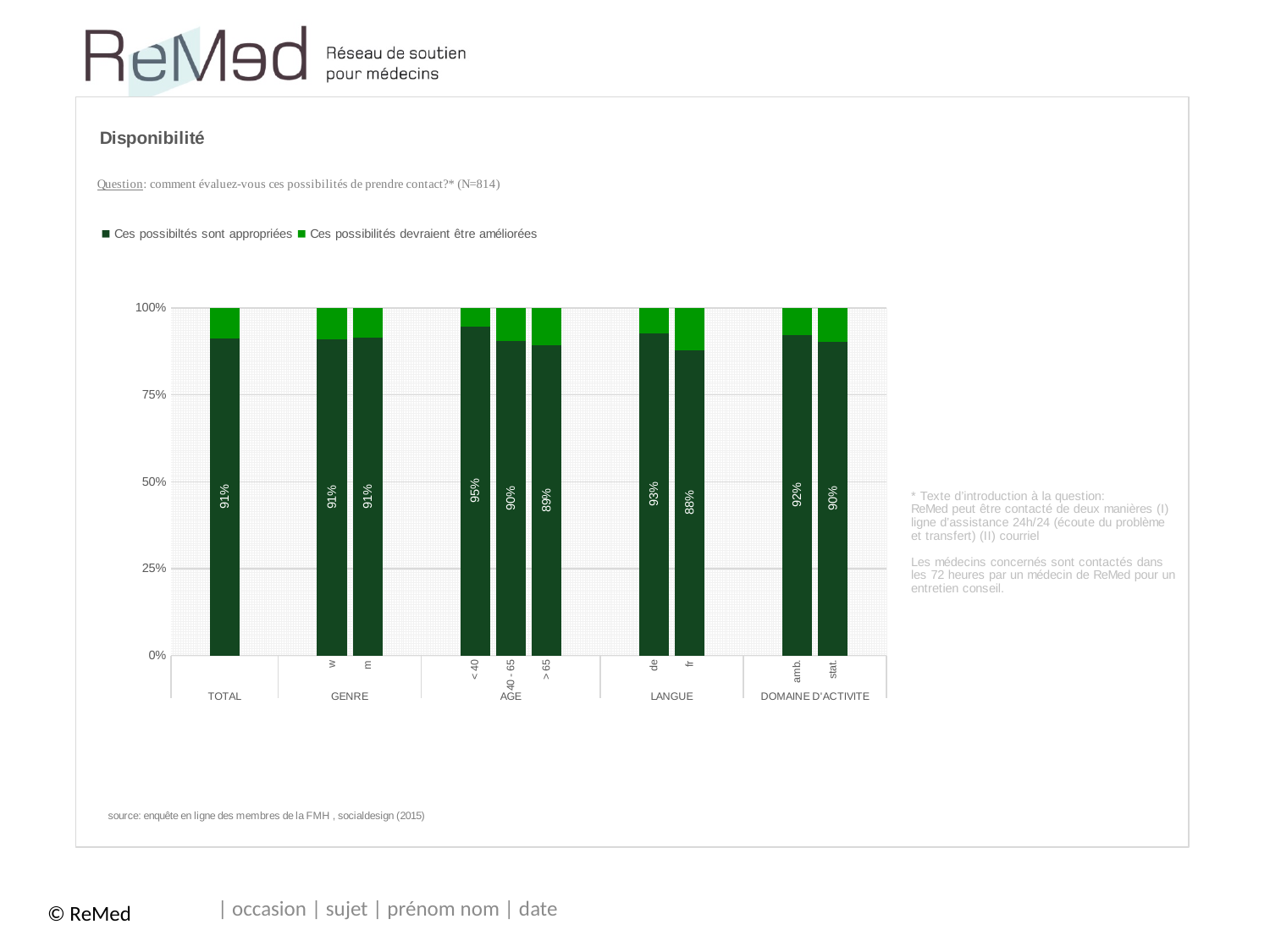
Which has a higher value for 'Ces possibiltés sont appropriées': 'amb.' or 'stat.'? amb. What is the value of 'Ces possibiltés sont appropriées' for 'stat.' in the DOMAINE D'ACTIVITE group? 90% Which category has the highest share of 'Ces possibiltés sont appropriées'? < 40 Is the 'Ces possibilités devraient être améliorées' share for 'fr' greater or less than 25%? less How many series does the legend list? 2 What is the value of 'Ces possibiltés sont appropriées' for the 'fr' language group? 88% What is the value of 'Ces possibiltés sont appropriées' for the '< 40' age group? 95% Which category has the lowest share of 'Ces possibiltés sont appropriées'? fr What is the difference in percentage points between 'de' and 'fr' for 'Ces possibiltés sont appropriées'? 5 What type of chart is shown on the slide? Stacked bar chart What percentage of respondents in the TOTAL group said 'Ces possibiltés sont appropriées'? 91% How many bars are plotted in the chart? 10